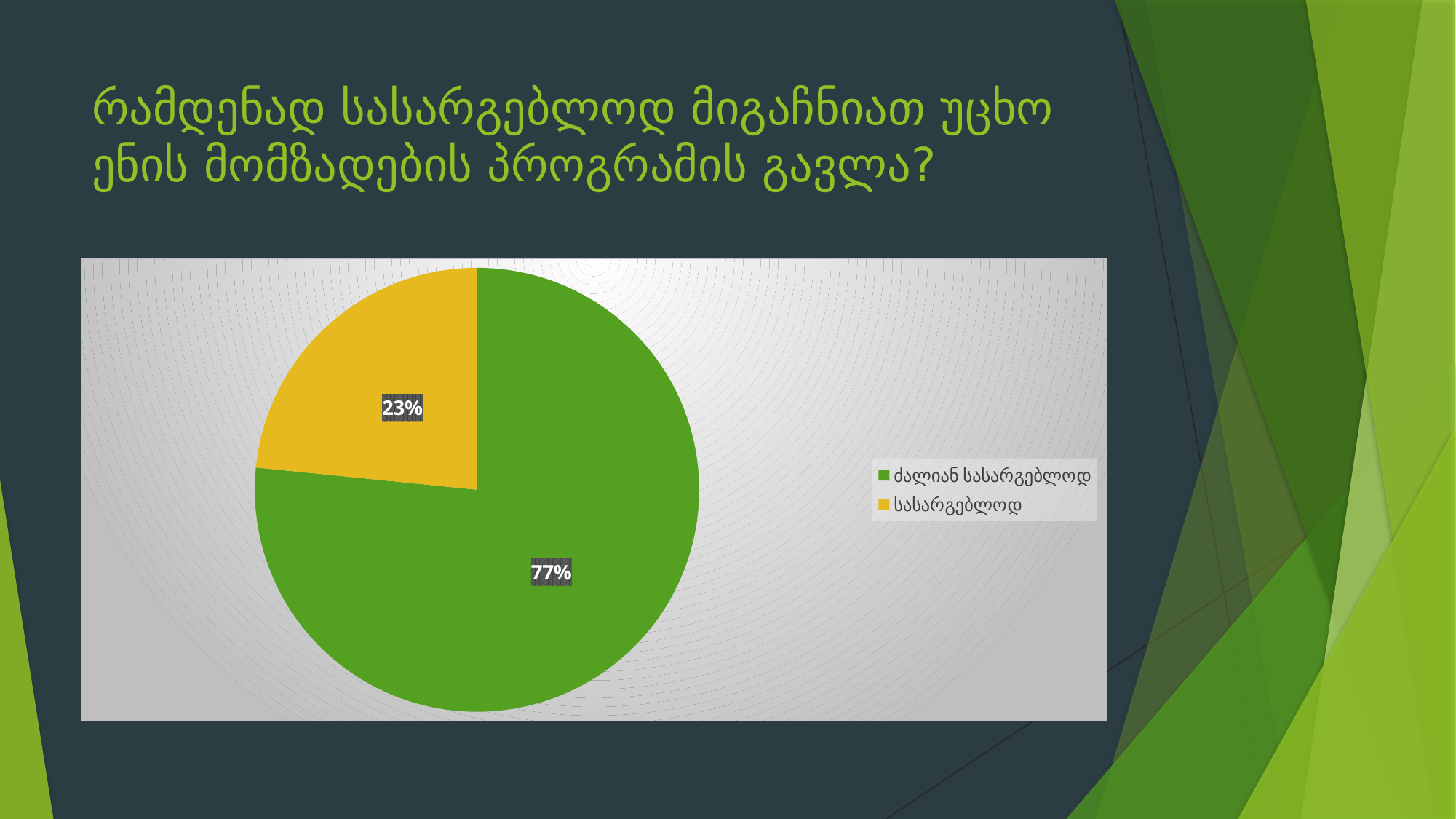
How many entries does the legend list? 2 What percentage is shown for the slice labelled "სასარგებლოდ"? 23% What colour is the slice labelled "სასარგებლოდ"? yellow What colour is the slice labelled "ძალიან სასარგებლოდ"? green How many slices does the pie chart have? 2 What share of the pie does the "სასარგებლოდ" slice represent? 23% What percentage is shown for the slice labelled "ძალიან სასარგებლოდ"? 77% What kind of chart is shown on the slide? pie chart What is the difference in percentage points between the "ძალიან სასარგებლოდ" slice and the "სასარგებლოდ" slice? 54 Which category has the smallest slice of the pie? სასარგებლოდ Which slice is larger, "ძალიან სასარგებლოდ" or "სასარგებლოდ"? ძალიან სასარგებლოდ Which category has the largest slice of the pie? ძალიან სასარგებლოდ